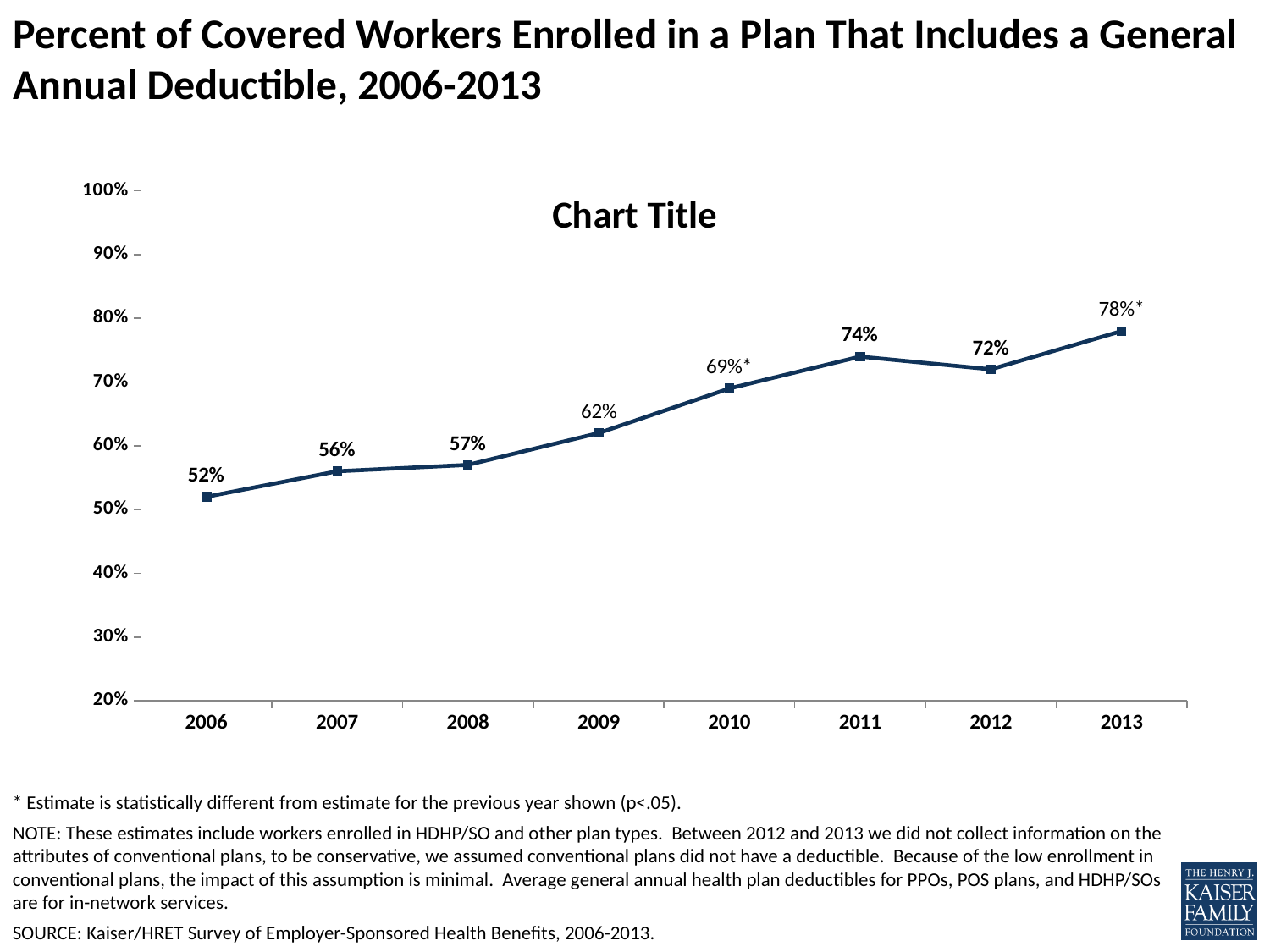
What is the value shown for 2010? 69% Which year has a higher value, 2011 or 2012? 2011 Do the values generally rise or fall from 2006 to 2013? Rise What does the asterisk next to some data labels indicate? Estimate is statistically different from estimate for the previous year shown (p<.05) What is the value shown for 2013? 78% Which year has the lowest value on the chart? 2006 Which year has the highest value on the chart? 2013 Is the value for 2009 greater or less than 60%? greater What is the difference between the 2013 value and the 2006 value? 26 percentage points What kind of chart is shown on the slide? Line chart How many years are plotted on the chart? 8 What percent of covered workers were enrolled in a plan with a general annual deductible in 2006? 52%